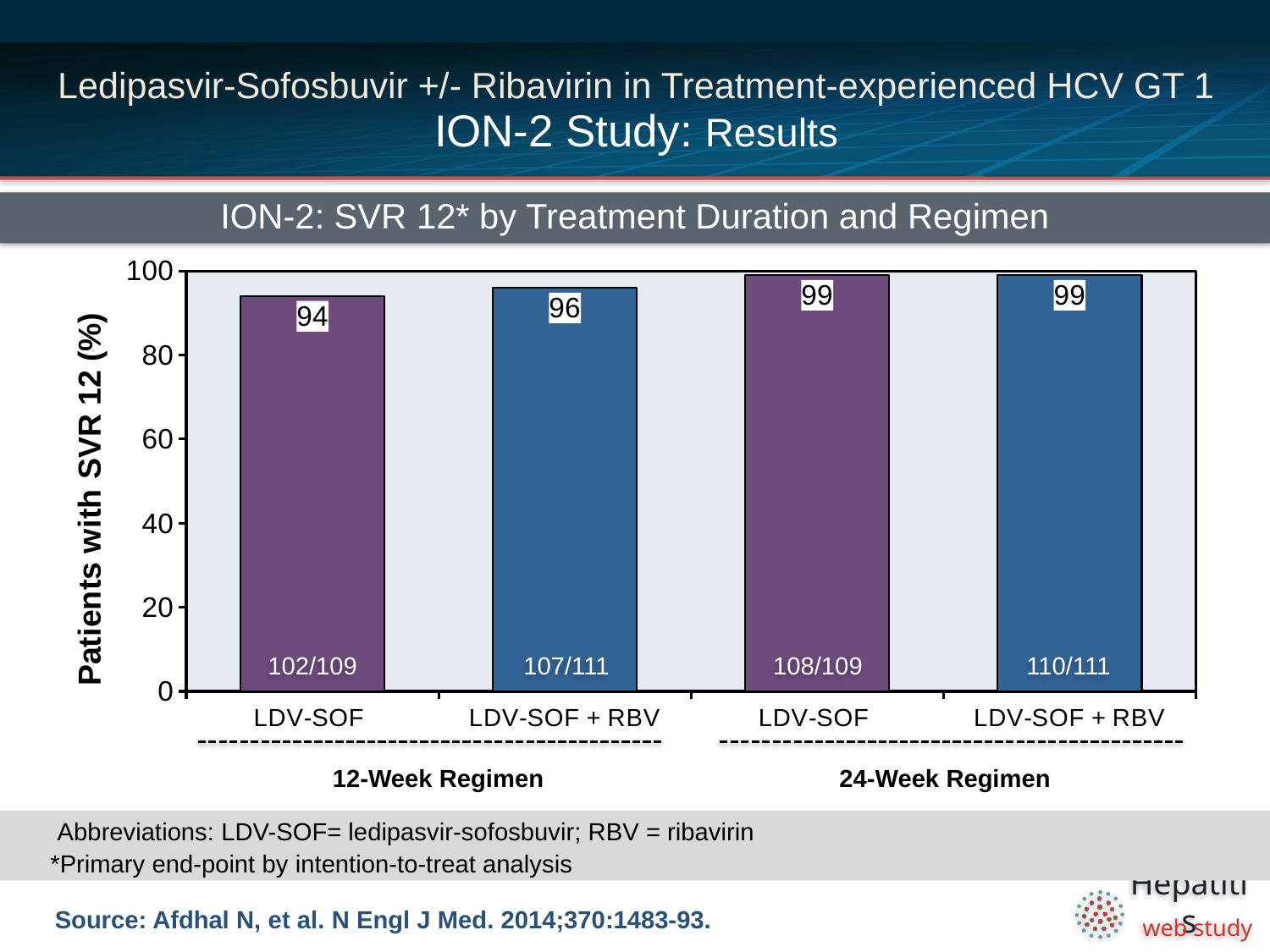
Which bar has the lowest SVR 12 rate? LDV-SOF, 12-Week Regimen What is the difference in SVR 12 rate between LDV-SOF + RBV and LDV-SOF in the 12-Week Regimen? 2 What fraction of patients achieved SVR 12 with LDV-SOF + RBV in the 24-Week Regimen? 110/111 How many bars are shown in the chart? 4 What is the label of the y-axis? Patients with SVR 12 (%) What fraction of patients achieved SVR 12 with LDV-SOF in the 12-Week Regimen? 102/109 What is the title of the chart? ION-2: SVR 12* by Treatment Duration and Regimen Which has a higher SVR 12 rate: LDV-SOF in the 12-Week Regimen or LDV-SOF in the 24-Week Regimen? LDV-SOF in the 24-Week Regimen What is the SVR 12 rate for LDV-SOF in the 24-Week Regimen? 99 What is the SVR 12 rate for LDV-SOF in the 12-Week Regimen? 94 What kind of chart is shown on the slide? Bar chart What is the SVR 12 rate for LDV-SOF + RBV in the 12-Week Regimen? 96